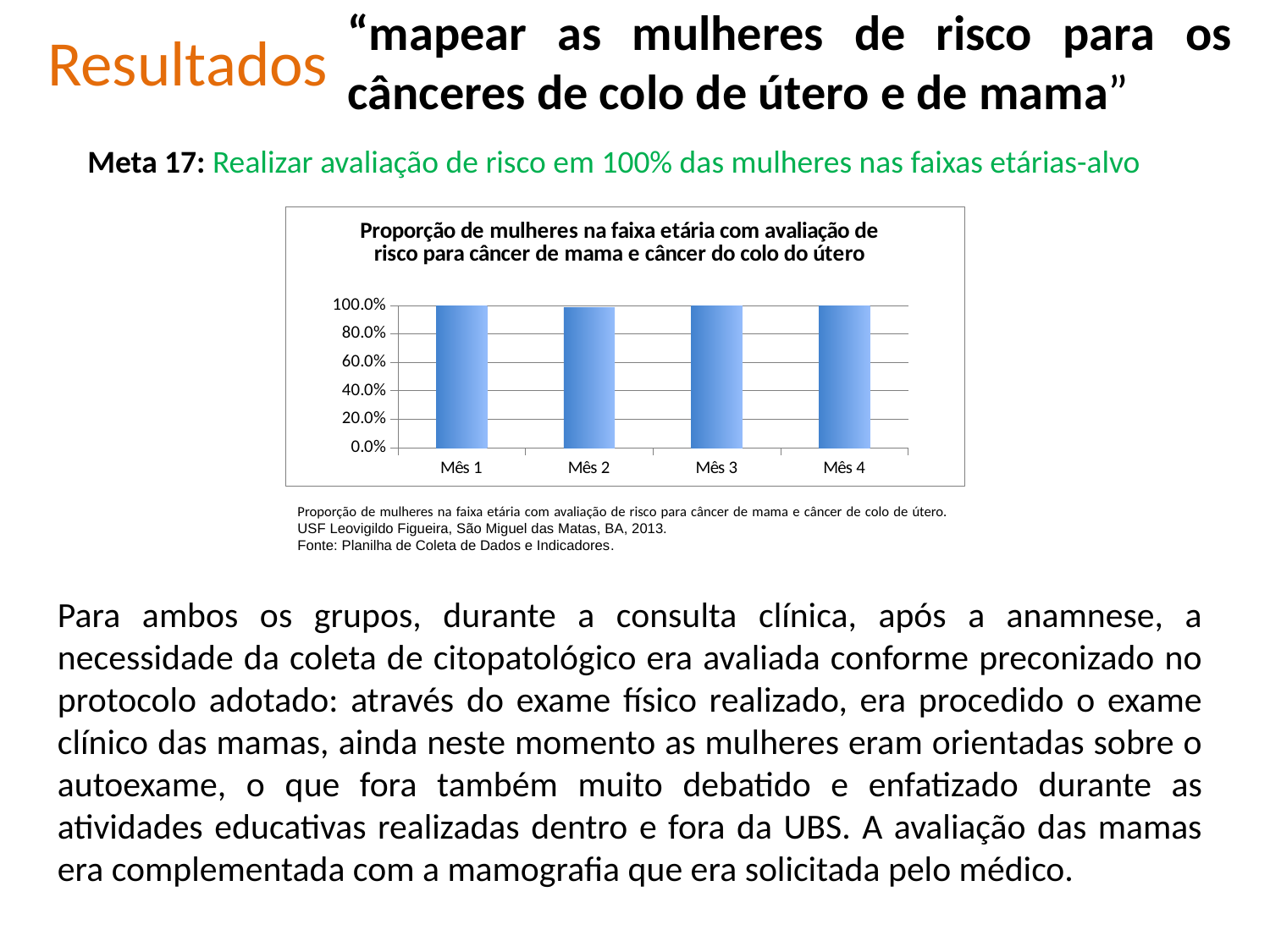
Is the value for Mês 2 greater or less than 40.0%? greater How many categories (months) are shown on the x axis of the chart? 4 What is the title of the chart? Proporção de mulheres na faixa etária com avaliação de risco para câncer de mama e câncer do colo do útero Is the value for Mês 2 greater or less than 80.0%? greater What is the label of the first category on the x axis? Mês 1 What is the highest value shown on the chart's y axis? 100.0% Is the value for Mês 3 greater or less than 60.0%? greater Do the values rise, fall, or stay roughly the same from Mês 1 to Mês 4? stay roughly the same What is the label of the last category on the x axis? Mês 4 What kind of chart is shown on the slide? bar chart